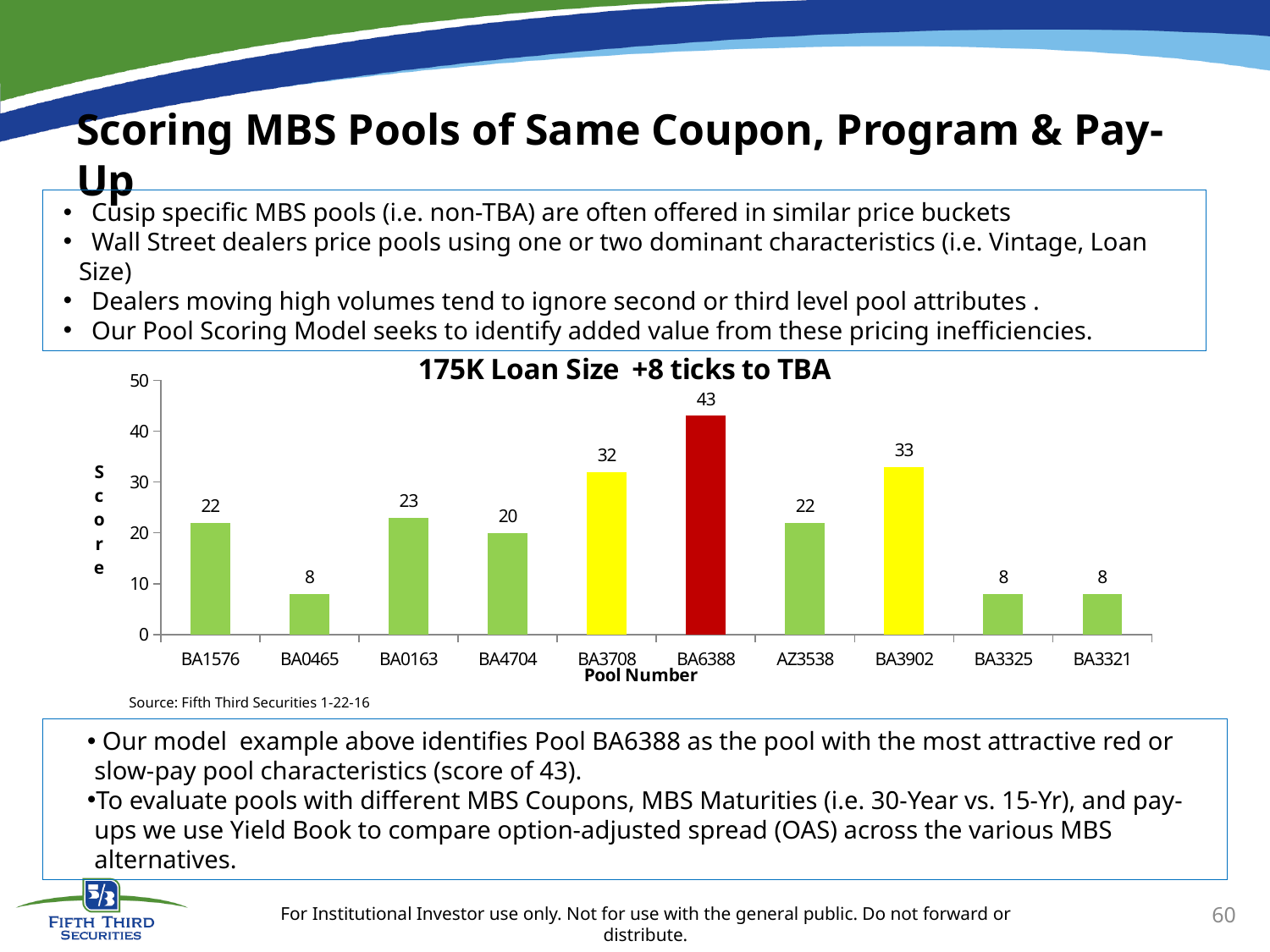
How many pools have a score of 8? 3 What colour is the bar for BA6388? red How many pools are shown on the x axis? 10 What is the title of the chart? 175K Loan Size +8 ticks to TBA Which has a higher score, BA0163 or AZ3538? BA0163 What is the score for pool BA4704? 20 What is the score for pool BA3708? 32 What is the difference between the scores of BA6388 and BA3902? 10 What is the score for pool BA6388? 43 Is the score for BA3902 greater or less than 30? greater Which pool has the highest score? BA6388 What kind of chart is shown on the slide? bar chart